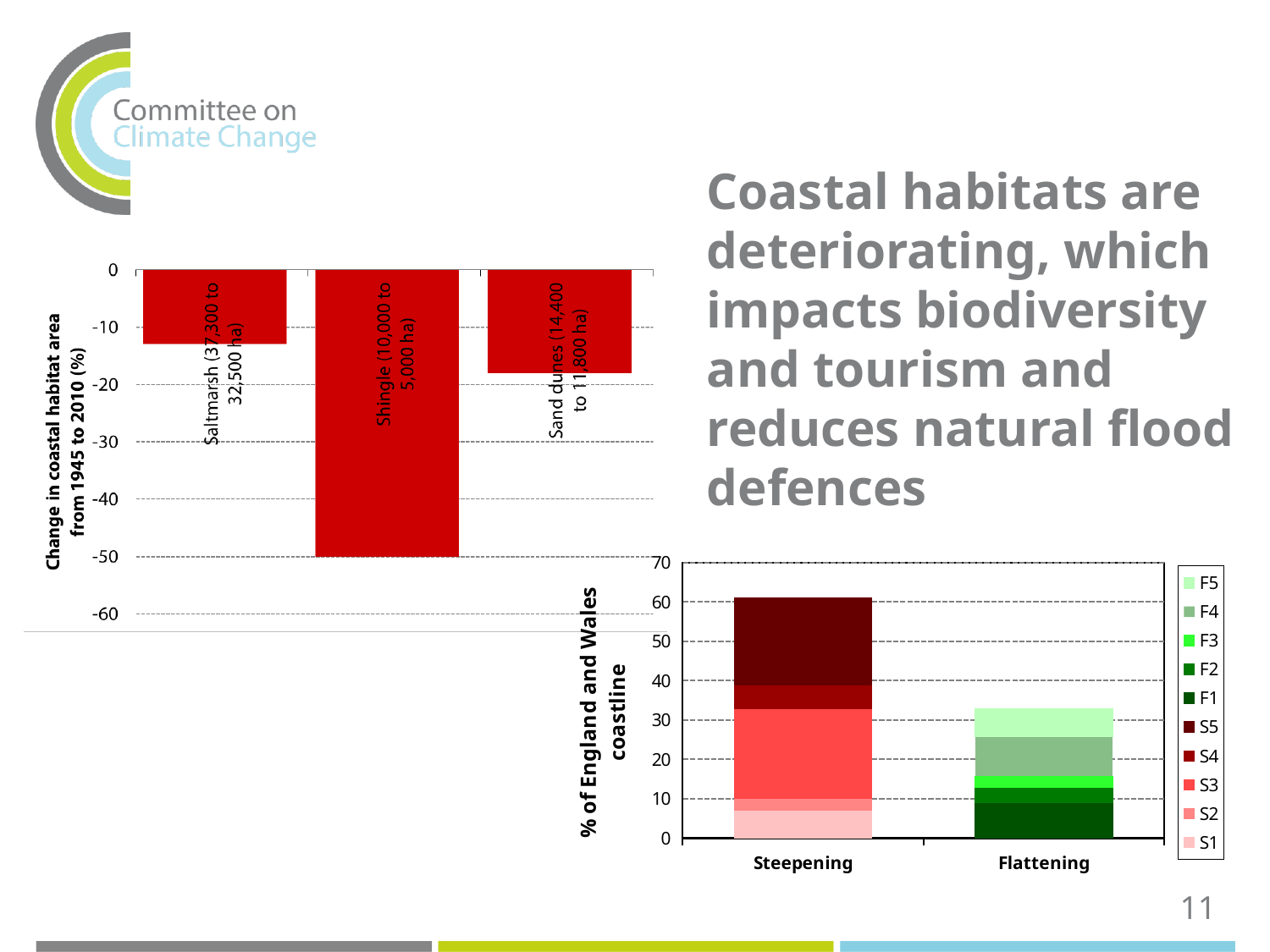
In the stacked bar chart on the right showing % of England and Wales coastline, is the total for Flattening greater or less than 40? less In the stacked bar chart on the right showing % of England and Wales coastline, how many series does the legend list? 10 In the stacked bar chart on the right showing % of England and Wales coastline, which category has the taller stacked bar, Steepening or Flattening? Steepening In the chart on the left showing change in coastal habitat area, what is the percentage change for Shingle? -50 In the chart on the left showing change in coastal habitat area, which habitat shows the largest percentage decrease? Shingle In the chart on the left showing change in coastal habitat area, is the value for Saltmarsh greater or less than -10? less In the chart on the left showing change in coastal habitat area, what kind of chart is it? bar chart In the chart on the left showing change in coastal habitat area, how many habitat categories are plotted? 3 In the chart on the left showing change in coastal habitat area, which declined by a larger percentage, Saltmarsh or Sand dunes? Sand dunes In the chart on the left showing change in coastal habitat area, which habitat shows the smallest percentage decrease? Saltmarsh In the stacked bar chart on the right showing % of England and Wales coastline, how many categories are shown on the x axis? 2 In the chart on the left showing change in coastal habitat area, is the value for Sand dunes greater or less than -20? greater